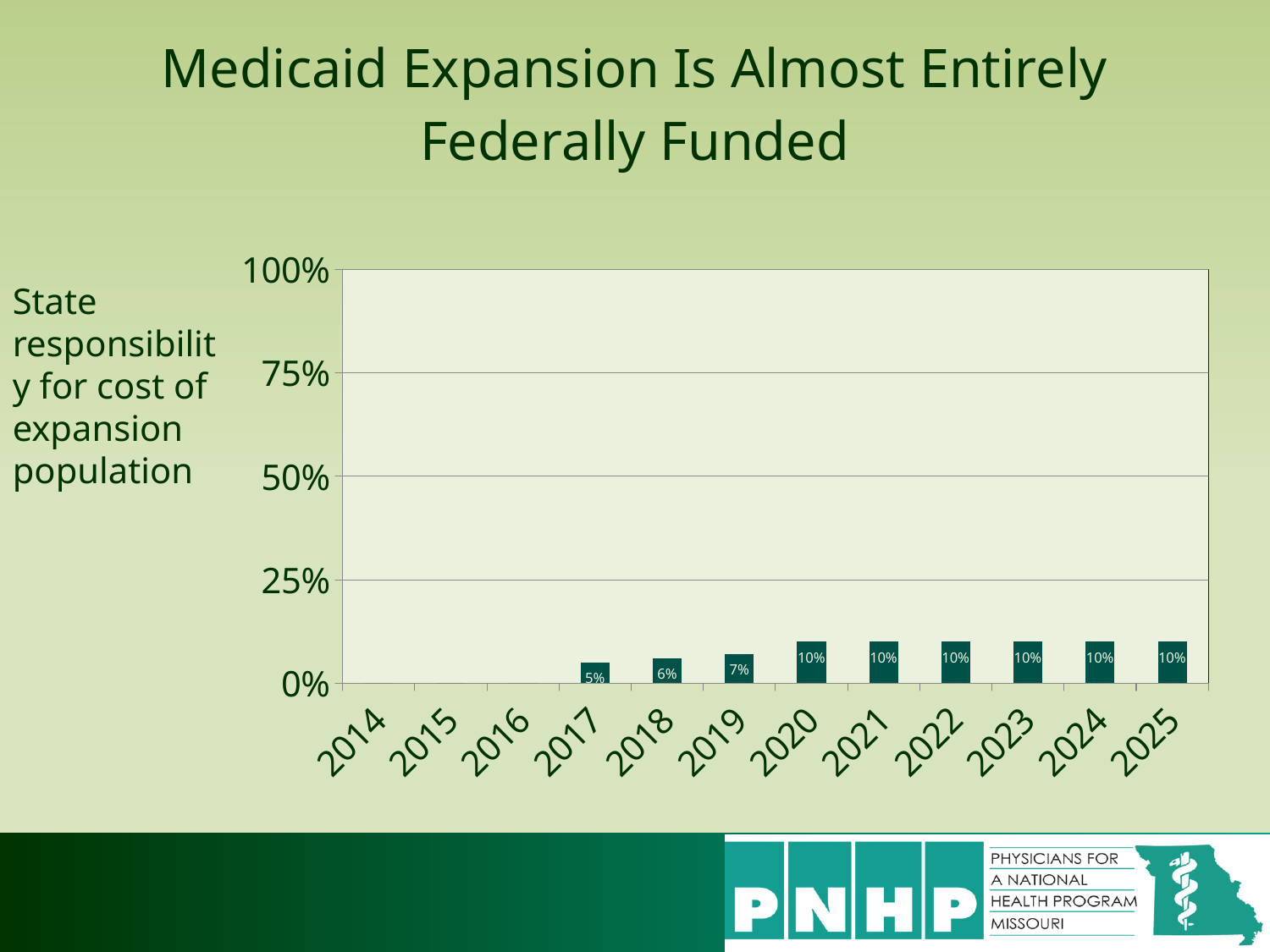
What is the value for 2022? 10% What is the value for 2017? 5% Do the values rise or fall from 2017 to 2020? rise Among the years with a visible bar, which year has the lowest value? 2017 What is the value for 2019? 7% What is the title of the slide? Medicaid Expansion Is Almost Entirely Federally Funded What kind of chart is shown on the slide? bar chart How many years are shown on the x axis? 12 What is the value for 2018? 6% What is the difference between the value for 2020 and the value for 2017? 5% Which is larger, the value for 2018 or the value for 2019? 2019 Is the value for 2025 greater or less than 25%? less